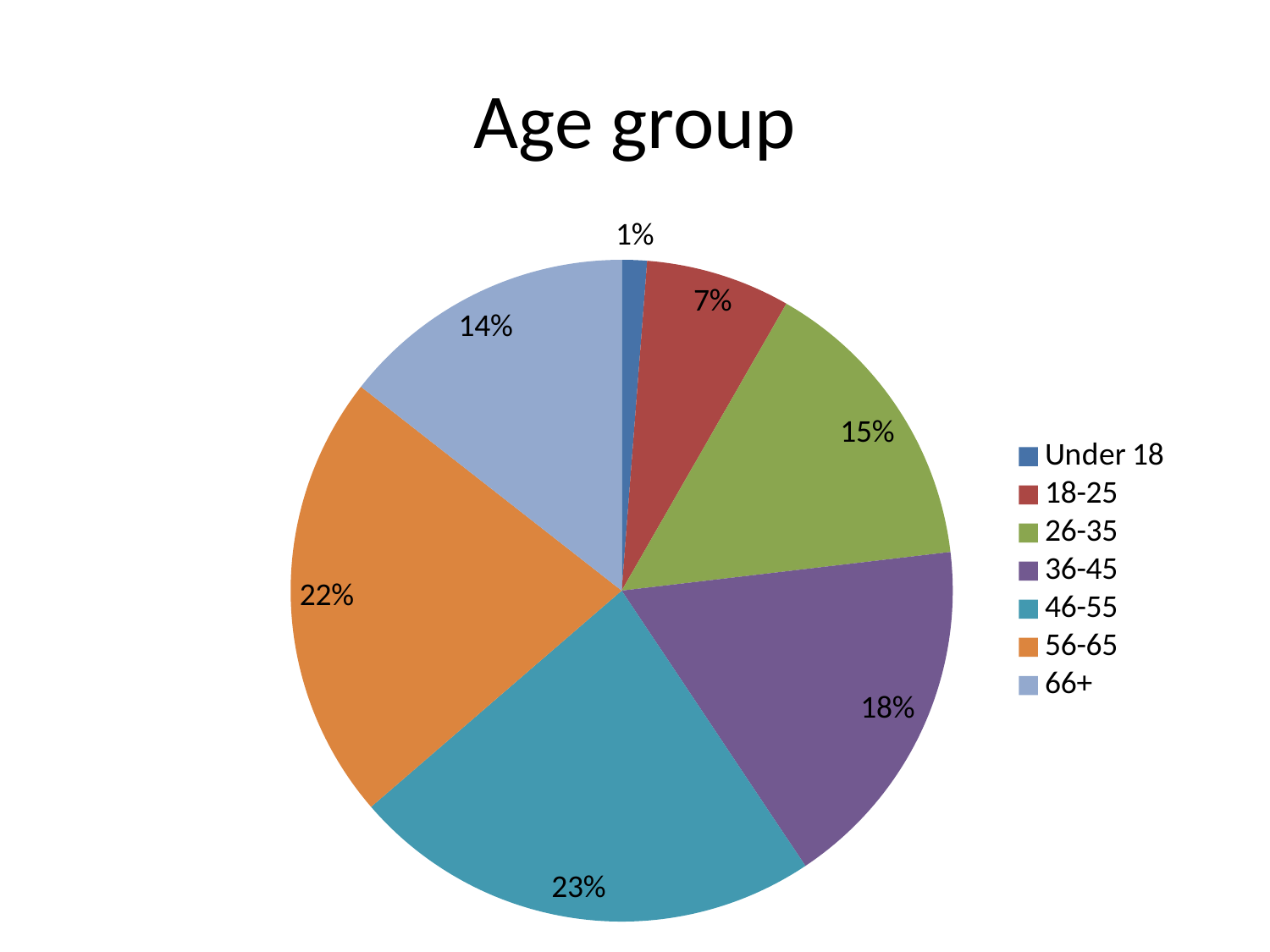
What is the value for the 26-35 age group? 15% Which age group has the smallest share of the pie? Under 18 What is the title of the chart? Age group What is the value for the 66+ age group? 14% What is the difference between the shares of the 36-45 and 18-25 age groups? 11% What is the combined share of the 18-25 and 26-35 age groups? 22% How many age groups are shown in the pie chart? 7 What type of chart is shown on the slide? pie chart What share of the pie does the 56-65 age group have? 22% Which is larger, the share for 26-35 or the share for 66+? 26-35 Which age group has the largest share of the pie? 46-55 What share of the pie does the 46-55 age group have? 23%